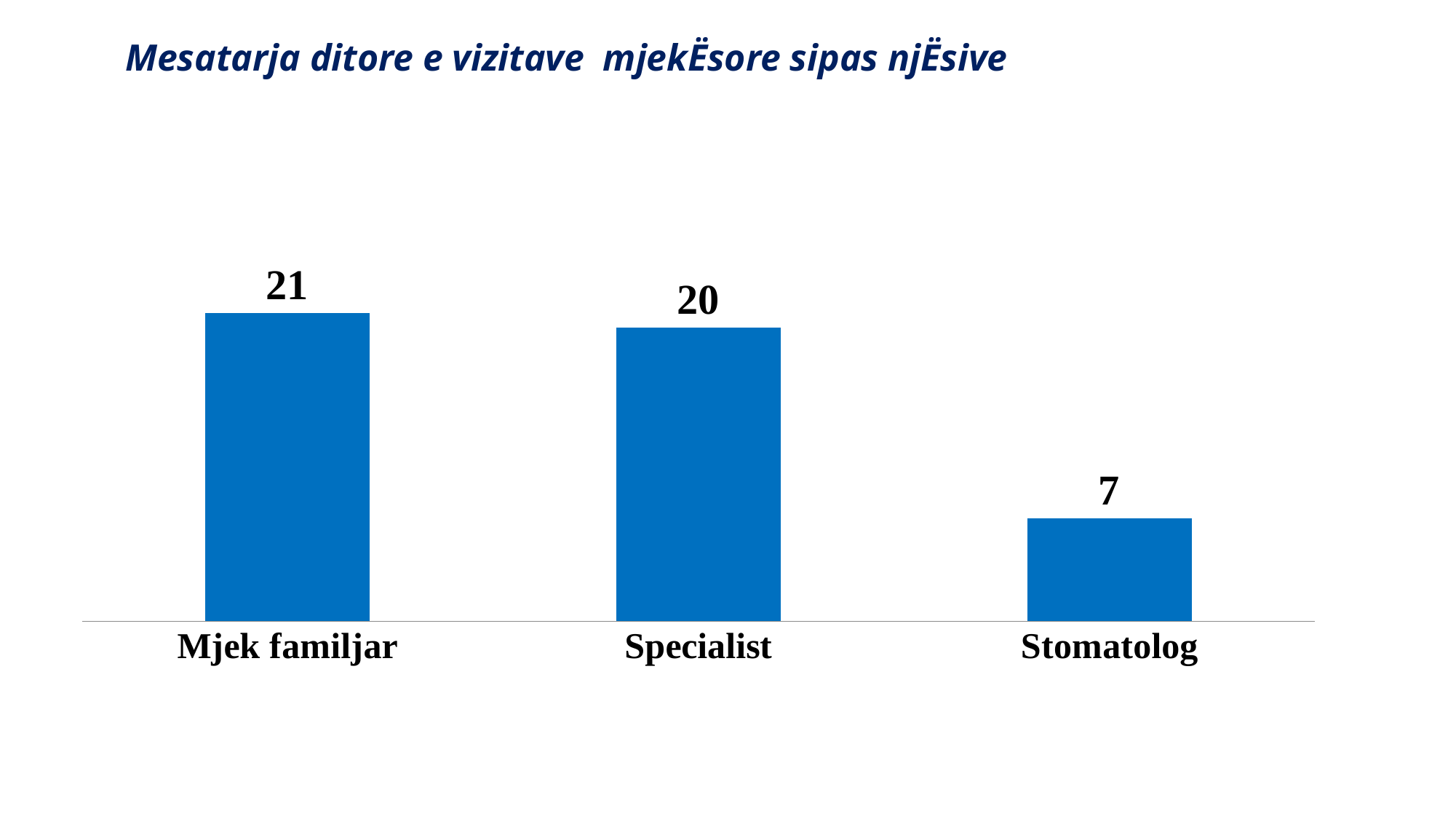
What is the title of the chart? Mesatarja ditore e vizitave mjekËsore sipas njËsive Do the values rise or fall from left to right across the categories? Fall What is the value for Specialist? 20 How many categories are shown in the chart? 3 What is the value for Stomatolog? 7 What is the value for Mjek familjar? 21 What is the difference between the values for Mjek familjar and Stomatolog? 14 Which is larger, the value for Specialist or the value for Stomatolog? Specialist What is the difference between the values for Specialist and Stomatolog? 13 Which category has the highest value? Mjek familjar What kind of chart is shown on the slide? Bar chart Which category has the lowest value? Stomatolog